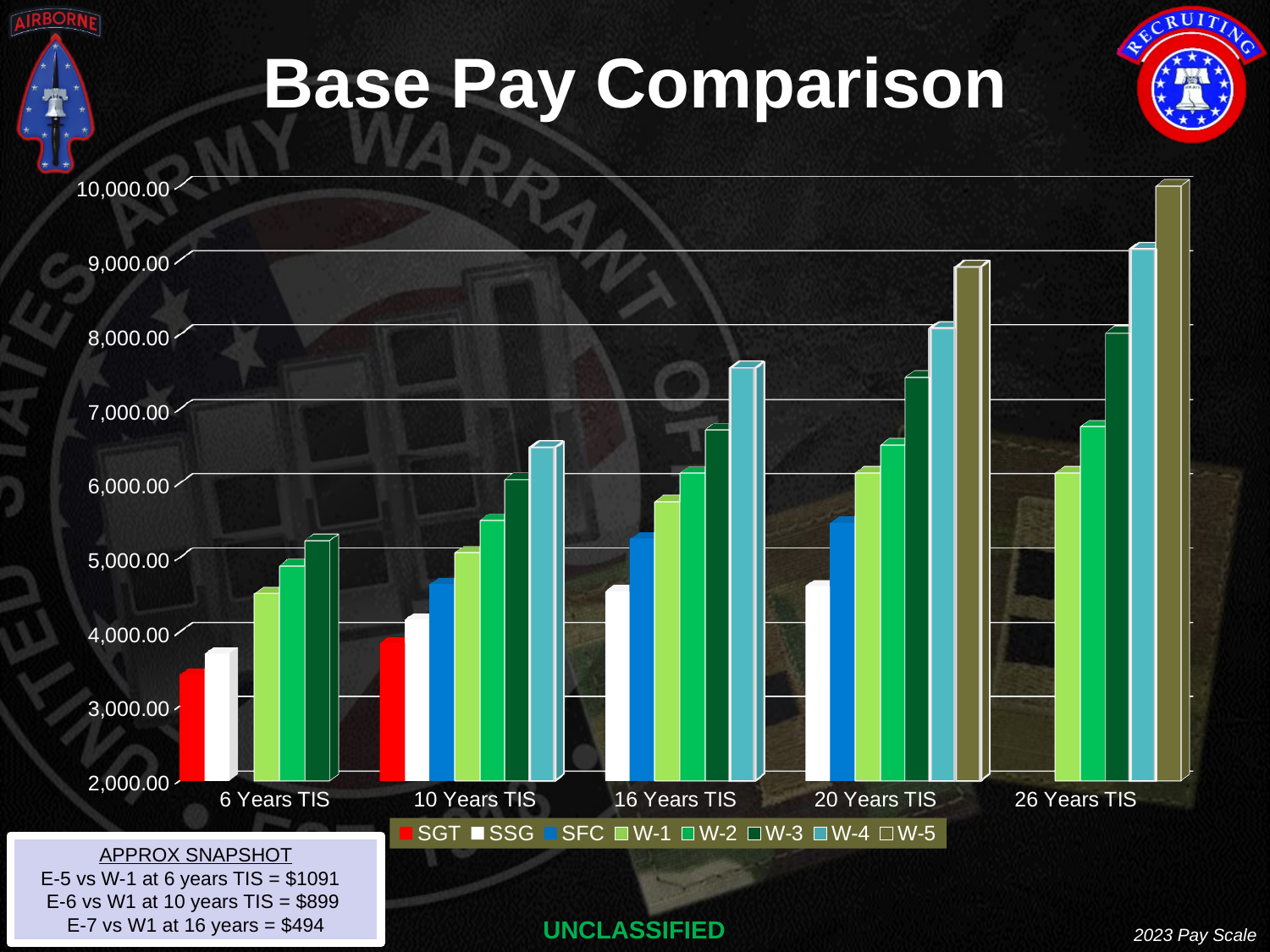
Which series has the shortest bar on the chart, and in which category? SGT at 6 Years TIS What kind of chart is shown on the slide? Bar chart How many series does the chart legend list? 8 Is the value for SGT at 6 Years TIS greater or less than 4,000.00? less At 16 Years TIS, which is larger: the W-4 bar or the W-3 bar? W-4 Which series has the tallest bar on the chart, and in which category? W-5 at 26 Years TIS What is the title of the chart? Base Pay Comparison Is the value for W-4 at 16 Years TIS greater or less than 7,000.00? greater Do the W-1 values rise or fall as years of TIS increase along the x axis? Rise How many time-in-service categories are shown on the x axis? 5 Is the value for W-2 at 26 Years TIS greater or less than 7,000.00? less